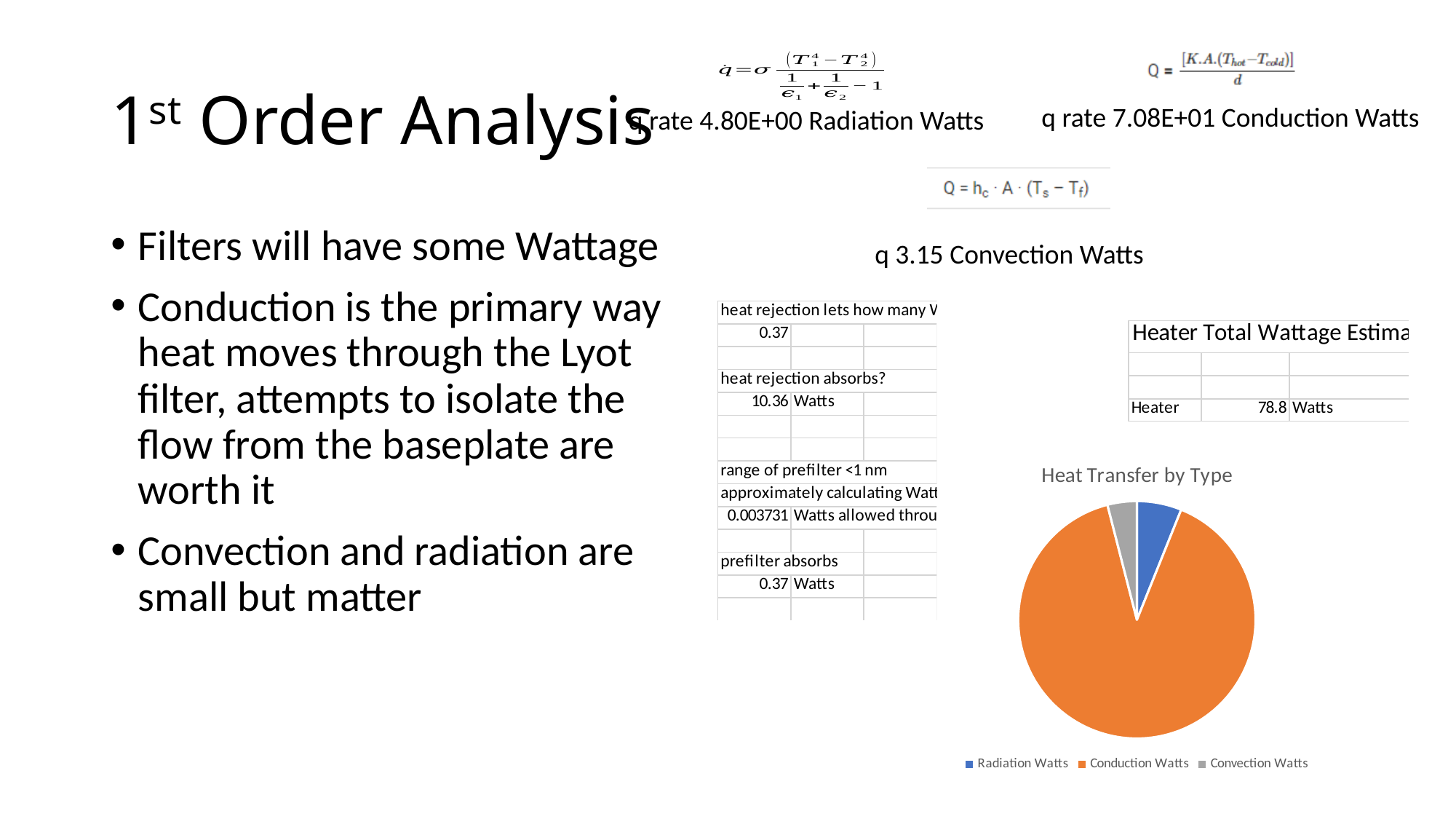
What colour is the Conduction Watts slice in the "Heat Transfer by Type" pie chart? orange How many entries does the legend of the "Heat Transfer by Type" chart list? 3 What is the title of the pie chart on the slide? Heat Transfer by Type In the "Heat Transfer by Type" pie chart, which category has the largest slice? Conduction Watts In the "Heat Transfer by Type" pie chart, which slice is larger: Conduction Watts or Radiation Watts? Conduction Watts In the "Heat Transfer by Type" pie chart, which category has the smallest slice? Convection Watts Which legend entry in the "Heat Transfer by Type" chart is shown in blue? Radiation Watts What kind of chart is the "Heat Transfer by Type" chart? pie chart How many slices does the "Heat Transfer by Type" pie chart have? 3 In the "Heat Transfer by Type" pie chart, which slice is larger: Radiation Watts or Convection Watts? Radiation Watts